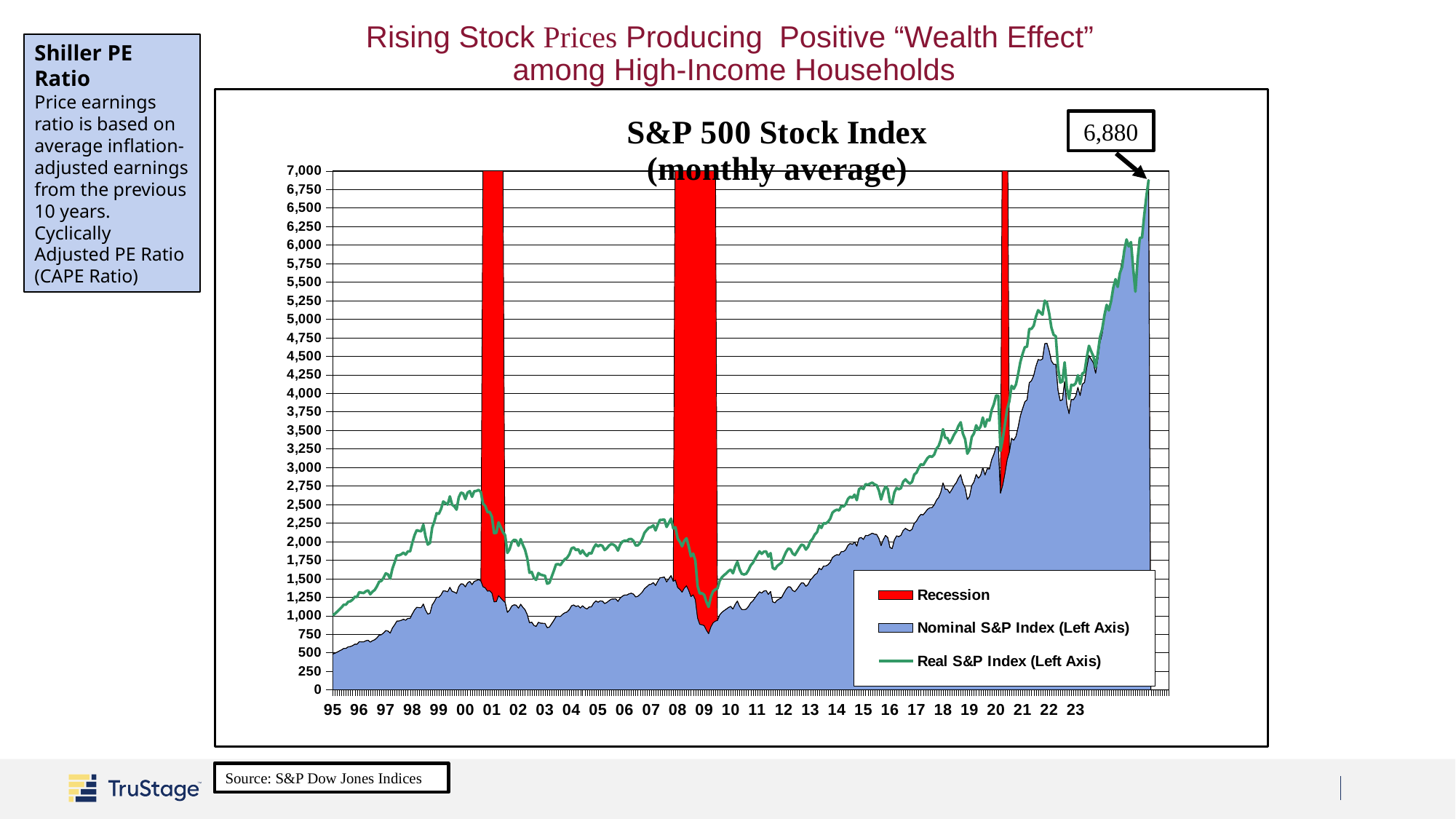
What is the highest value shown on the y axis? 7,000 What kind of chart is this? area and line chart How many entries does the chart's legend list? 3 Does the Nominal S&P Index generally rise or fall from 95 to 23? rise What value does the callout label at the end of the series show? 6,880 Is the Real S&P Index value at its 2000 peak greater or less than 2,000? greater Is the Nominal S&P Index value at its 2022 peak greater or less than 4,000? greater Is the Nominal S&P Index value at the start of 95 greater or less than 1,000? less How many recession bars are shaded on the chart? 3 What is the title of the chart? S&P 500 Stock Index (monthly average) In 2010, which is higher, the Real S&P Index or the Nominal S&P Index? Real S&P Index